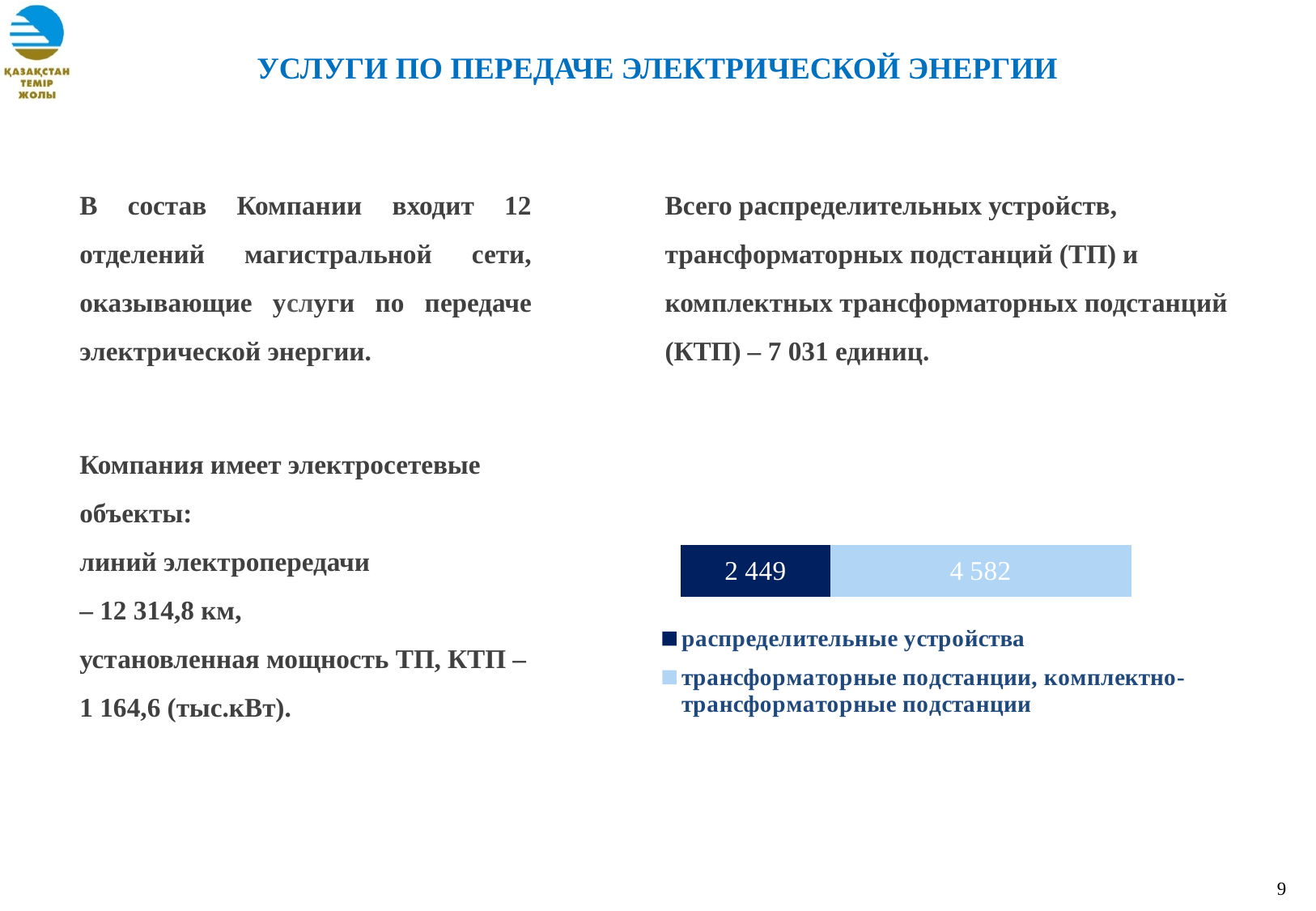
What kind of chart is shown on the slide? stacked bar chart Which colour represents трансформаторные подстанции, комплектно-трансформаторные подстанции in the chart? light blue Which series has the smaller value in the chart? распределительные устройства What is the difference between the values for трансформаторные подстанции, комплектно-трансформаторные подстанции and распределительные устройства? 2 133 Which series has the larger value in the chart? трансформаторные подстанции, комплектно-трансформаторные подстанции What is the value for распределительные устройства in the chart? 2 449 Which colour represents распределительные устройства in the chart? dark blue What is the value for трансформаторные подстанции, комплектно-трансформаторные подстанции in the chart? 4 582 Is the value for распределительные устройства larger or smaller than the value for трансформаторные подстанции, комплектно-трансформаторные подстанции? smaller How many series does the legend list? 2 What is the total of the stacked bar in the chart? 7 031